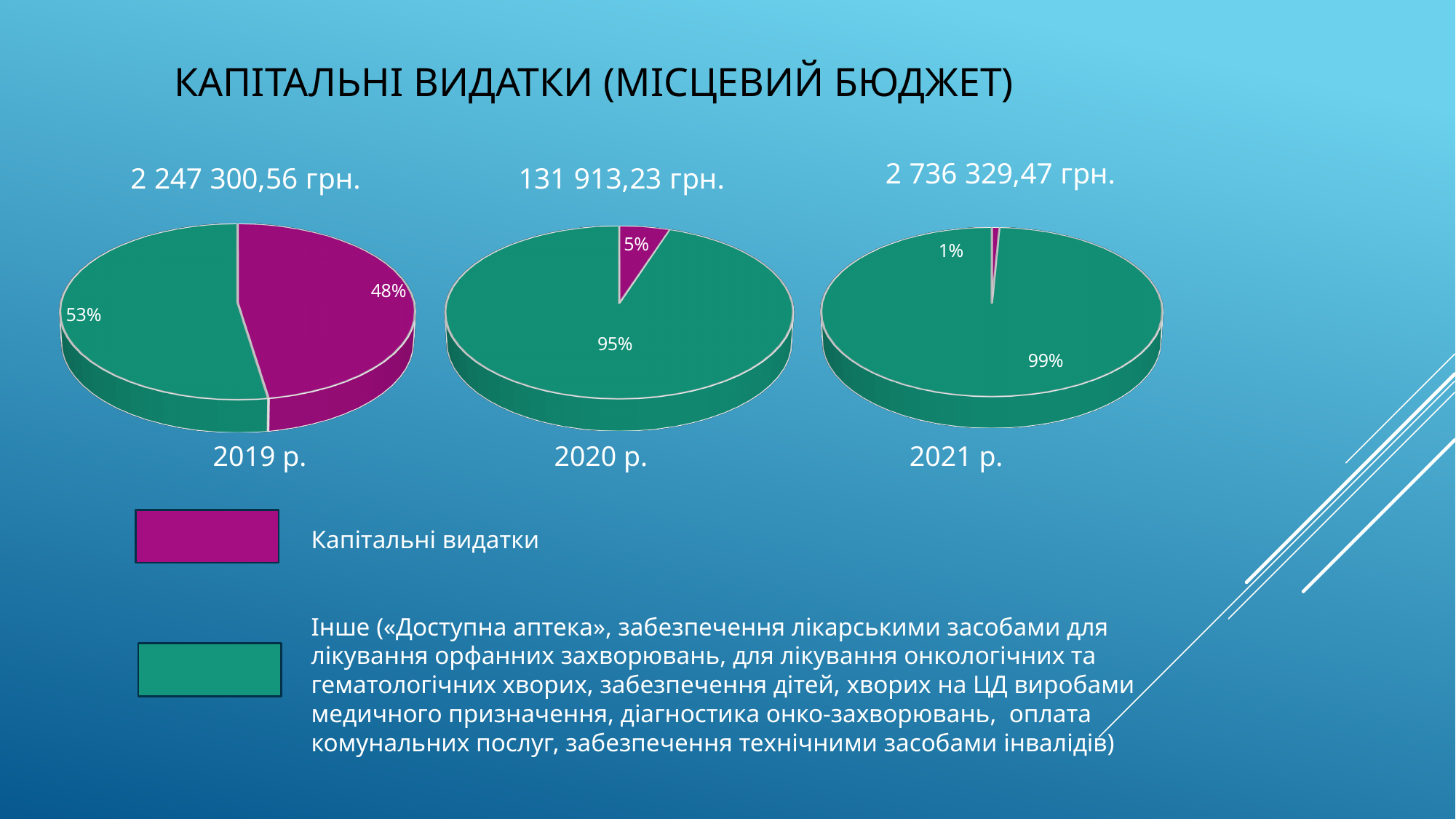
In the 2021 р. pie chart, what share is labelled for the Інше slice? 99% In the 2019 р. pie chart, what share is labelled for Капітальні видатки (the magenta slice)? 48% What total amount is shown above the 2020 р. pie chart? 131 913,23 грн. What total amount is shown above the 2019 р. pie chart? 2 247 300,56 грн. In the 2020 р. pie chart, what share is labelled for the Інше slice? 95% How many pie charts are shown on the slide? 3 Which year's pie chart has the largest share for Капітальні видатки? 2019 р. What total amount is shown above the 2021 р. pie chart? 2 736 329,47 грн. What kind of charts are shown on the slide? Pie charts